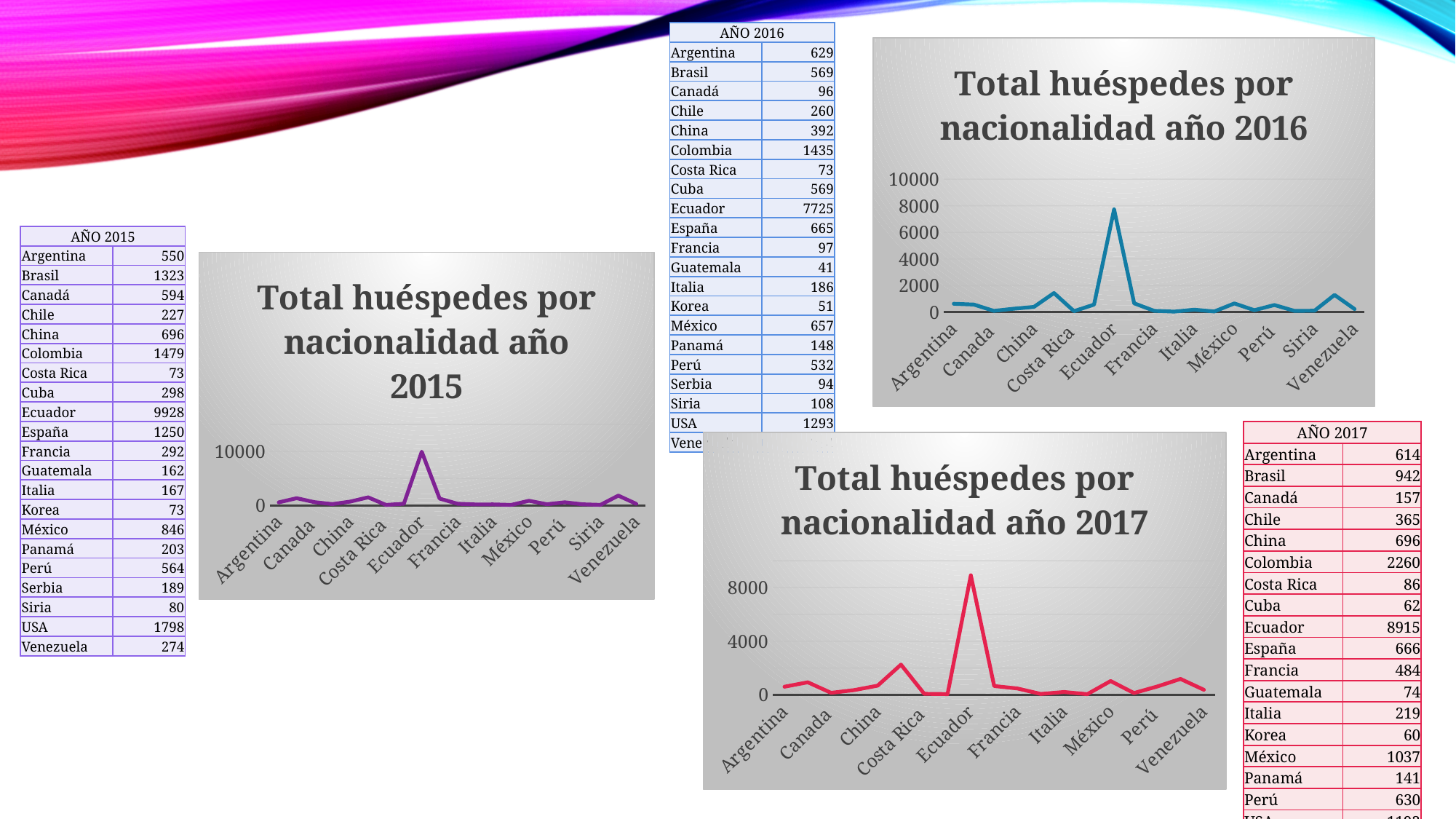
In the chart 'Total huéspedes por nacionalidad año 2017', is the value for Colombia greater or less than 4000? less According to the AÑO 2017 table, what is the value for Colombia? 2260 What kind of chart is 'Total huéspedes por nacionalidad año 2015'? line chart In the chart 'Total huéspedes por nacionalidad año 2017', which nationality has the highest value? Ecuador According to the AÑO 2016 table, what is the value for USA? 1293 In the chart 'Total huéspedes por nacionalidad año 2016', is the value for Ecuador greater or less than 6000? greater According to the AÑO 2016 table, which nationality has the lowest value? Guatemala In the chart 'Total huéspedes por nacionalidad año 2016', which nationality has the highest value? Ecuador What colour is the line in the chart 'Total huéspedes por nacionalidad año 2016'? blue According to the AÑO 2015 table, what is the value for Ecuador? 9928 Using the AÑO 2017 table, what is the difference between the values for Ecuador and Colombia? 6655 In the chart 'Total huéspedes por nacionalidad año 2017', which is larger, the value for Ecuador or the value for Colombia? Ecuador